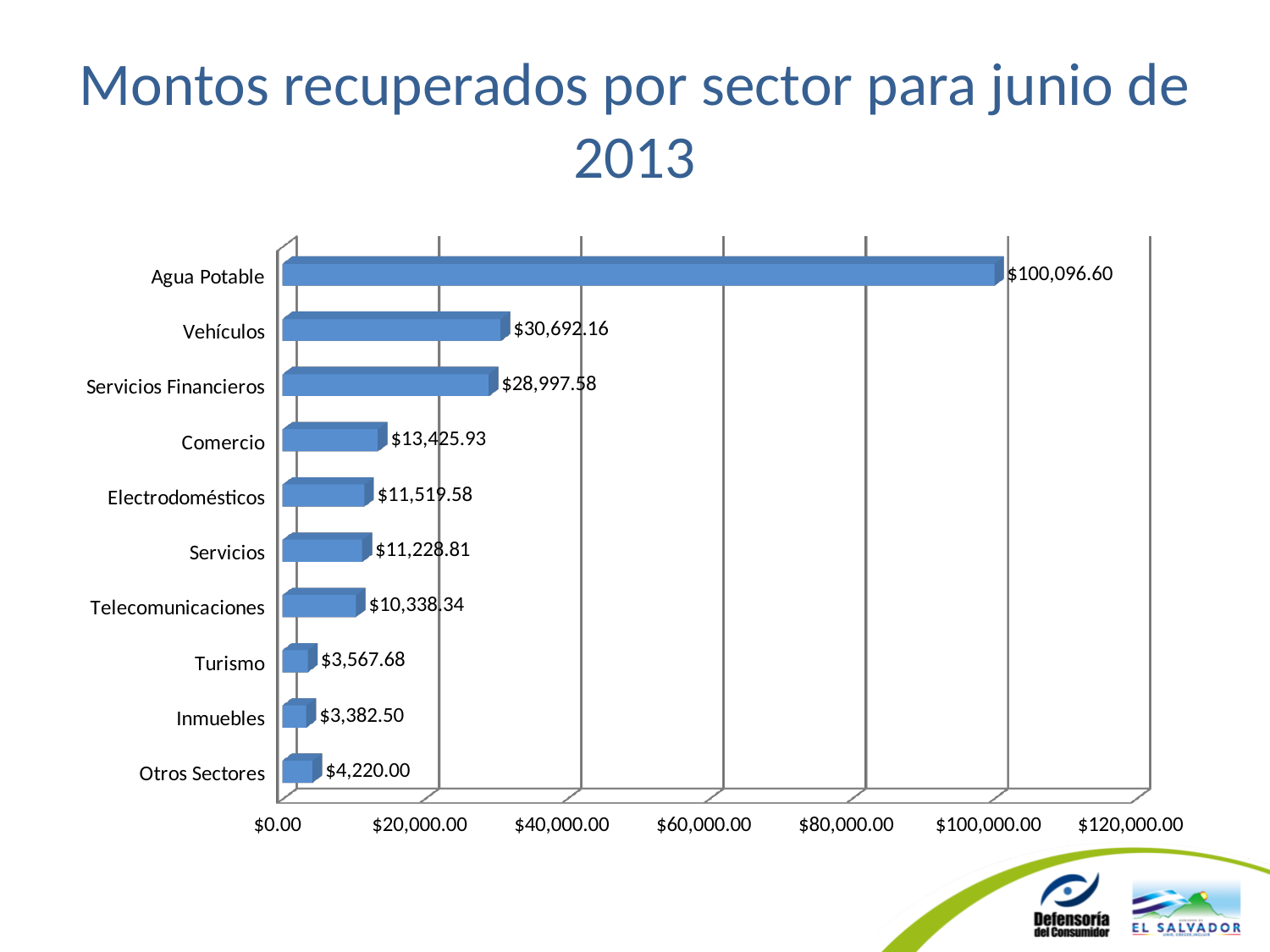
What is the difference between the values for Vehículos and Servicios Financieros? $1,694.58 What kind of chart is shown on the slide? Bar chart Which sector has the lowest recovered amount? Inmuebles What is the difference between the values for Agua Potable and Vehículos? $69,404.44 What is the value for Otros Sectores? $4,220.00 Which is larger, the value for Comercio or the value for Electrodomésticos? Comercio What is the value for Agua Potable? $100,096.60 How many sectors are shown in the chart? 10 What is the value for Telecomunicaciones? $10,338.34 What is the title of the slide? Montos recuperados por sector para junio de 2013 Which sector has the highest recovered amount? Agua Potable Is the value for Agua Potable greater or less than $80,000.00? greater